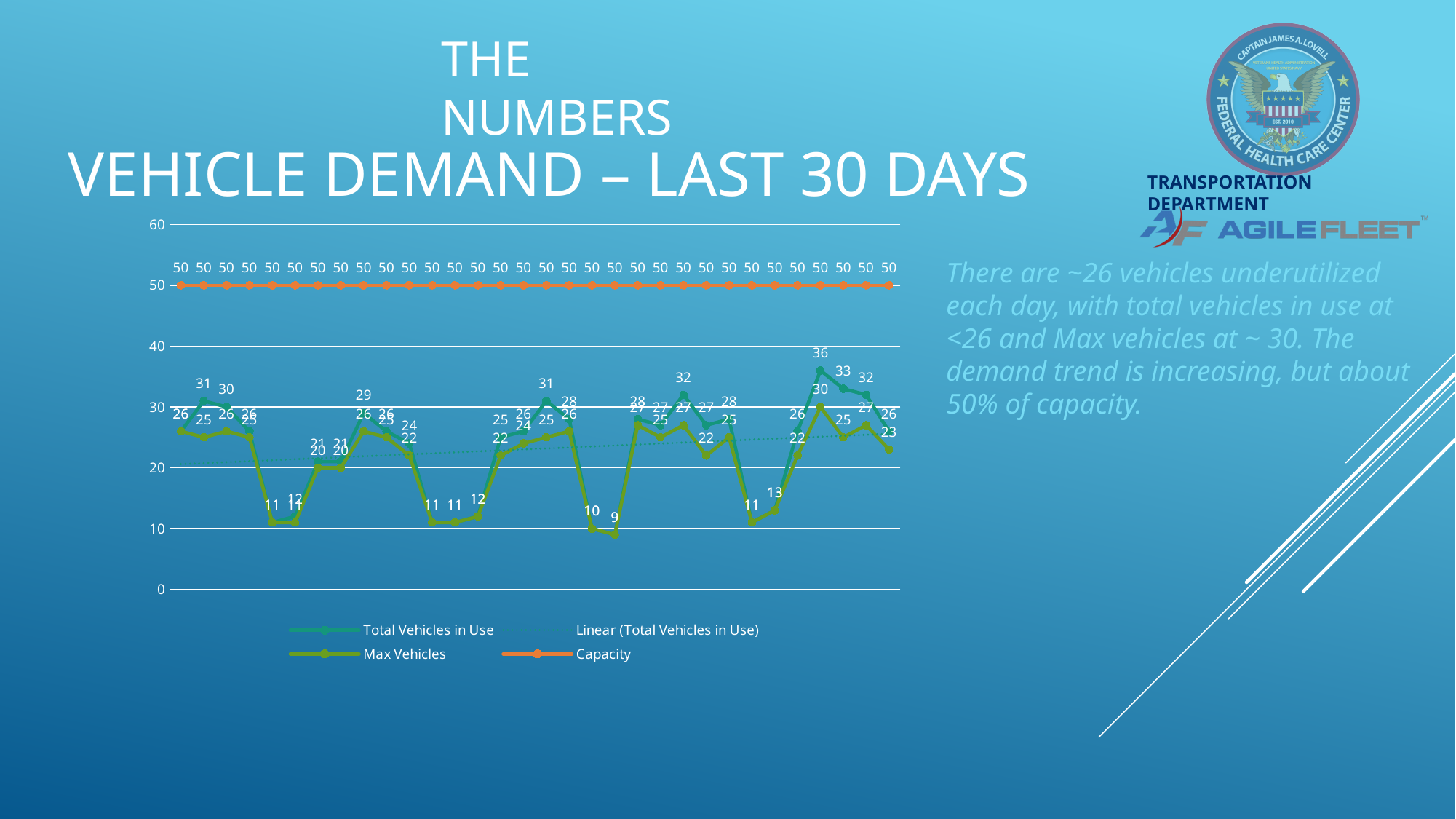
Is the Capacity line greater or less than 40 on the y axis? greater What is the maximum value shown on the y axis? 60 How many series does the chart legend list? 4 Which is larger, the Capacity value of 50 or the peak Total Vehicles in Use value of 36? Capacity (50) What is the difference between the Capacity value of 50 and the peak Total Vehicles in Use value of 36? 14 Does the Capacity line rise, fall, or stay flat across the chart? stays flat What kind of chart is shown on the slide? line chart What is the lowest value labeled among the vehicle lines on the chart? 9 What value does the Capacity series hold at every point? 50 What is the highest value labeled on the Total Vehicles in Use line? 36 What colour is the Capacity line in the chart? orange